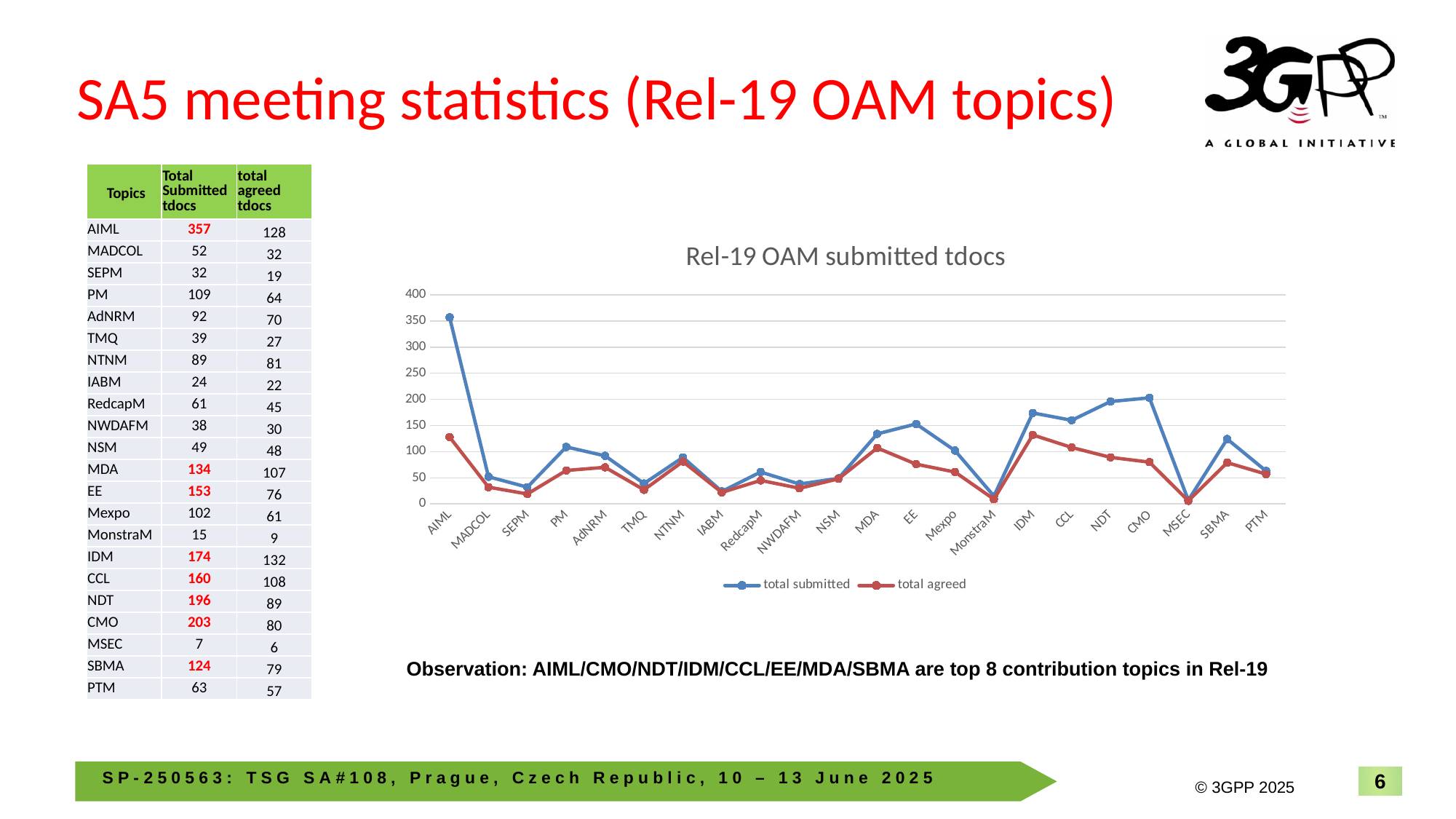
What is the difference between total submitted and total agreed tdocs for NDT? 107 What type of chart is shown on the slide? line chart What is the total agreed tdocs value for AIML? 128 What is the total submitted tdocs value for CMO? 203 How many series does the chart legend list? 2 Is the total agreed value for MonstraM greater or less than 50? less What is the title of the chart? Rel-19 OAM submitted tdocs How many topics are plotted along the x axis of the chart? 22 Is the total submitted value for AIML greater or less than 300? greater Which topic has the lowest total submitted tdocs? MSEC Which is larger, total submitted tdocs for IDM or for CCL? IDM Which topic has the highest total submitted tdocs? AIML